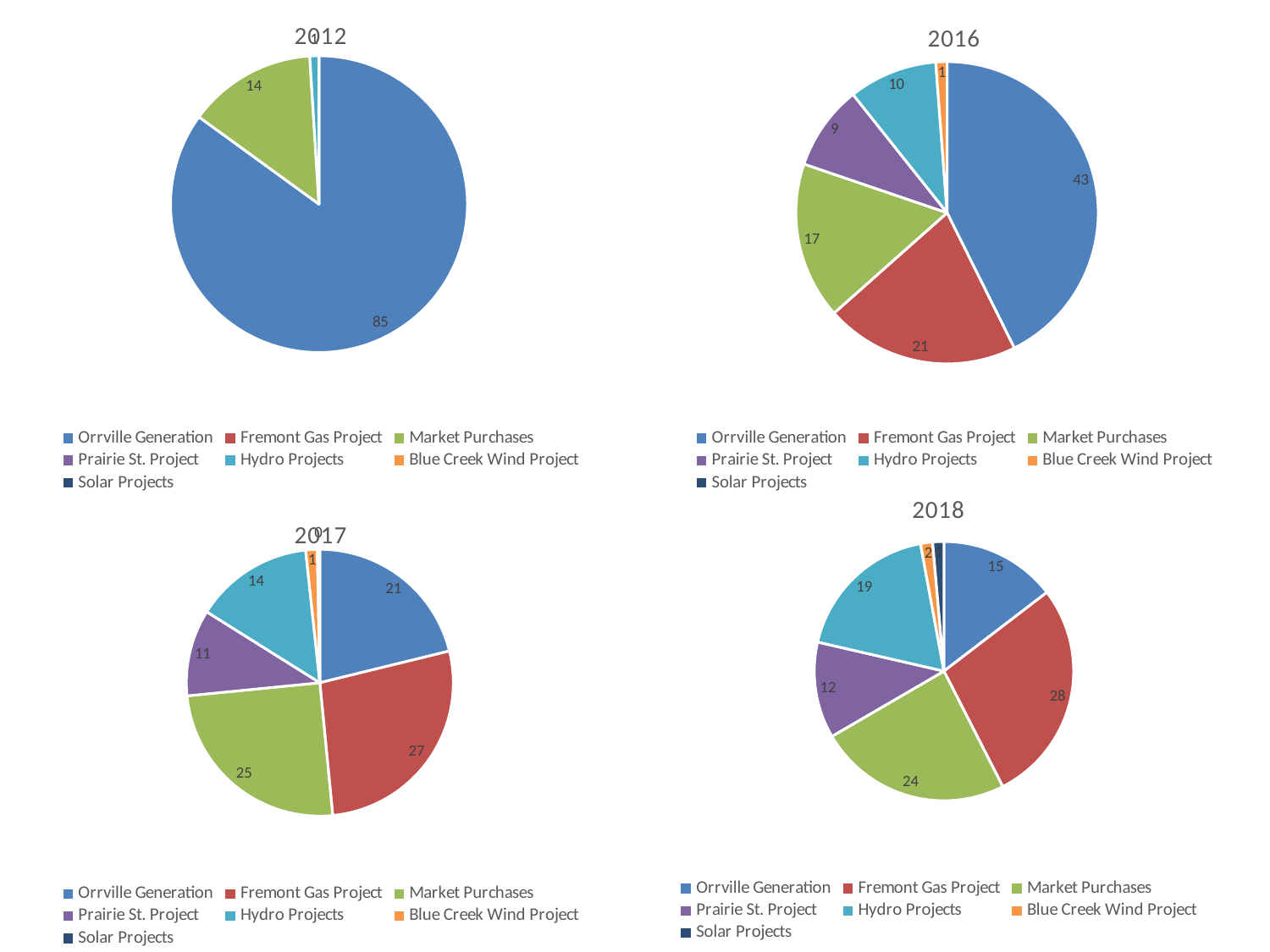
In the 2012 pie chart, what is the value for Market Purchases? 14 How many entries does the legend of the 2018 chart list? 7 In the 2018 pie chart, what is the difference between Fremont Gas Project and Orrville Generation? 13 In the 2016 pie chart, which category has the largest slice? Orrville Generation In the 2016 pie chart, what is the difference between Orrville Generation and Market Purchases? 26 In the 2012 pie chart, what is the value for Orrville Generation? 85 In the 2018 pie chart, what is the value for Prairie St. Project? 12 In the 2017 pie chart, what is the value for Hydro Projects? 14 In the 2016 pie chart, what is the value for Fremont Gas Project? 21 In the 2017 pie chart, which category has the largest slice? Fremont Gas Project What kind of chart is the 2016 chart? Pie chart In the 2017 pie chart, which is larger, Market Purchases or Orrville Generation? Market Purchases